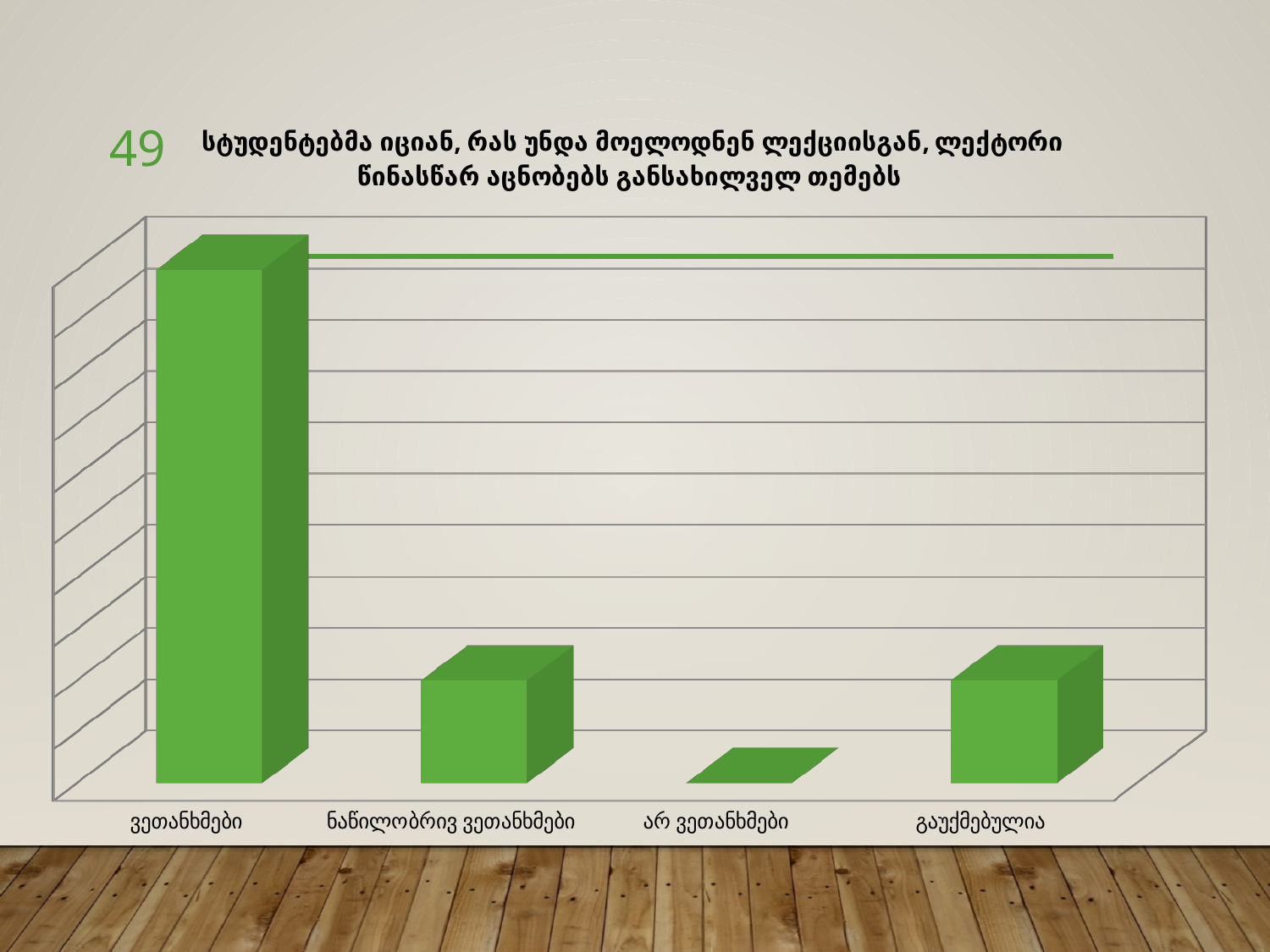
What is the label of the first category on the x axis of the chart? ვეთანხმები Which is larger, the bar for ნაწილობრივ ვეთანხმები or the bar for არ ვეთანხმები? ნაწილობრივ ვეთანხმები What colour are the bars in the chart? green How many categories are shown on the x axis of the chart? 4 Which category has the lowest bar in the chart? არ ვეთანხმები Which category has the highest bar in the chart? ვეთანხმები Which is larger, the bar for ვეთანხმები or the bar for გაუქმებულია? ვეთანხმები Which is larger, the bar for ვეთანხმები or the bar for ნაწილობრივ ვეთანხმები? ვეთანხმები What kind of chart is shown on the slide? bar chart